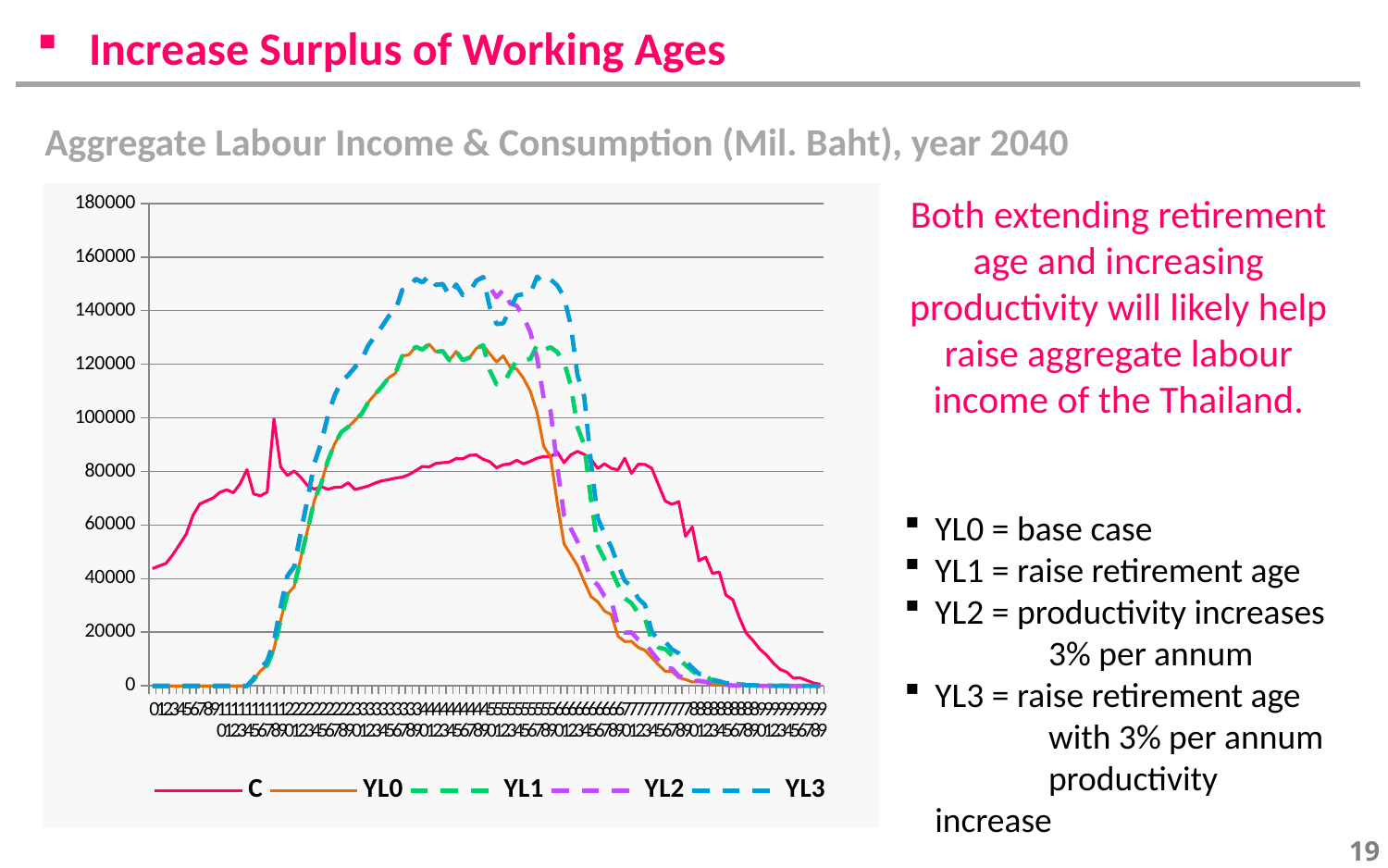
Which series reaches the highest peak value on the chart? YL2 and YL3 (tied) Do the YL0 values rise or fall along the x axis between ages 60 and 80? fall What is the title of the chart? Aggregate Labour Income & Consumption (Mil. Baht), year 2040 Which has a higher peak value, the YL3 series or the YL0 series? YL3 What are the series names listed in the chart legend? C, YL0, YL1, YL2, YL3 Is the value of the C series at age 0 greater or less than 60000? less How many series does the chart legend list? 5 Is the peak value of the YL3 series greater or less than 140000? greater What is the highest value shown on the vertical axis? 180000 What kind of chart is shown on the slide? line chart Is the peak value of the YL1 series greater or less than 100000? greater